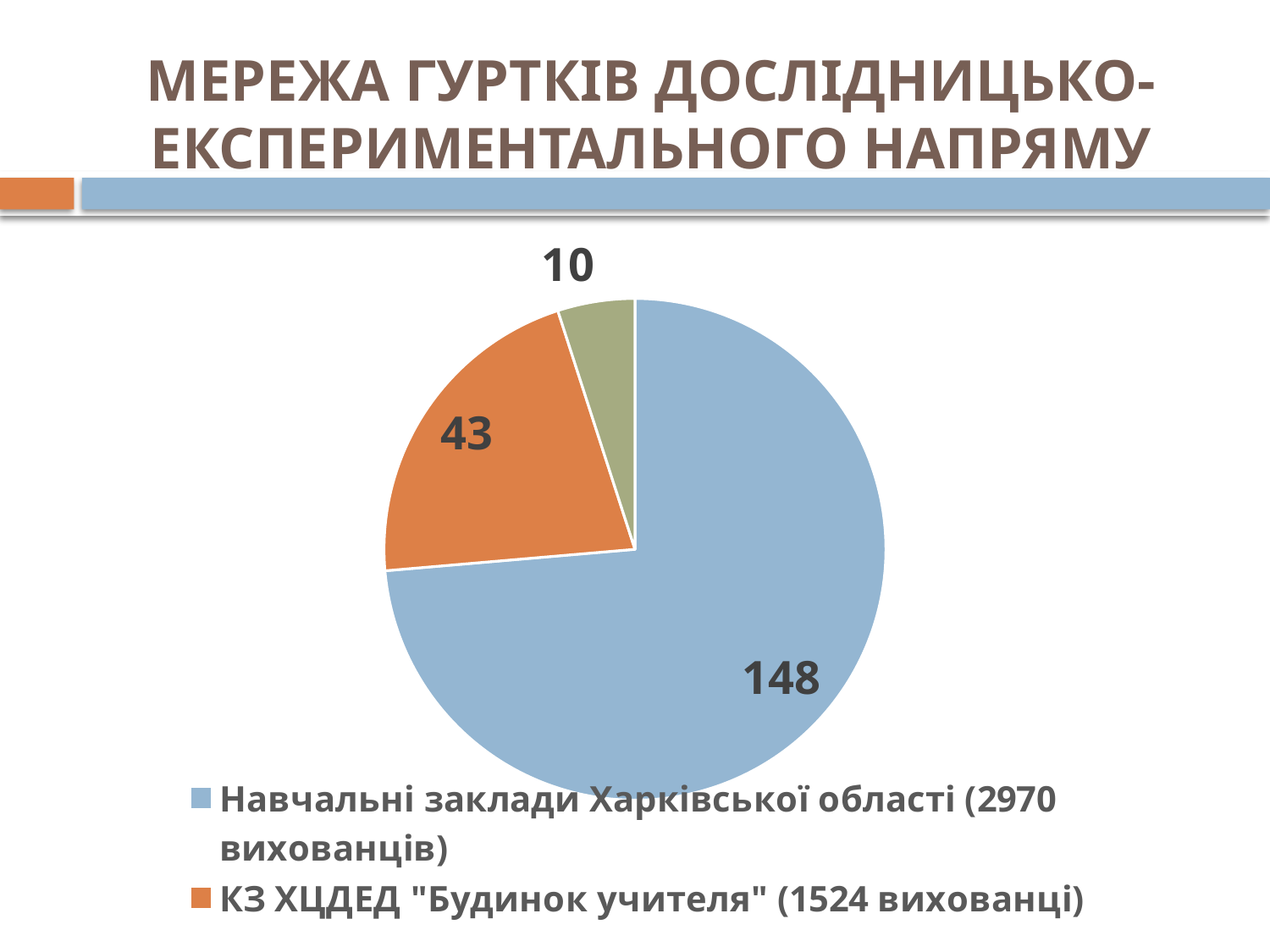
How many entries does the legend list? 2 What is the total of all the values shown on the pie chart? 201 What is the title of the slide? МЕРЕЖА ГУРТКІВ ДОСЛІДНИЦЬКО-ЕКСПЕРИМЕНТАЛЬНОГО НАПРЯМУ What is the value of the smallest slice in the pie chart? 10 What value is shown for the slice "Навчальні заклади Харківської області (2970 вихованців)"? 148 What kind of chart is shown on the slide? pie chart What colour is the slice labelled 43? orange What is the difference between the value for "Навчальні заклади Харківської області" and the value for "КЗ ХЦДЕД "Будинок учителя""? 105 What value is shown for the slice "КЗ ХЦДЕД "Будинок учителя" (1524 вихованці)"? 43 Which slice of the pie chart is the largest? Навчальні заклади Харківської області (2970 вихованців) Which is larger: the slice for "Навчальні заклади Харківської області" or the slice for "КЗ ХЦДЕД "Будинок учителя""? Навчальні заклади Харківської області How many slices does the pie chart have? 3